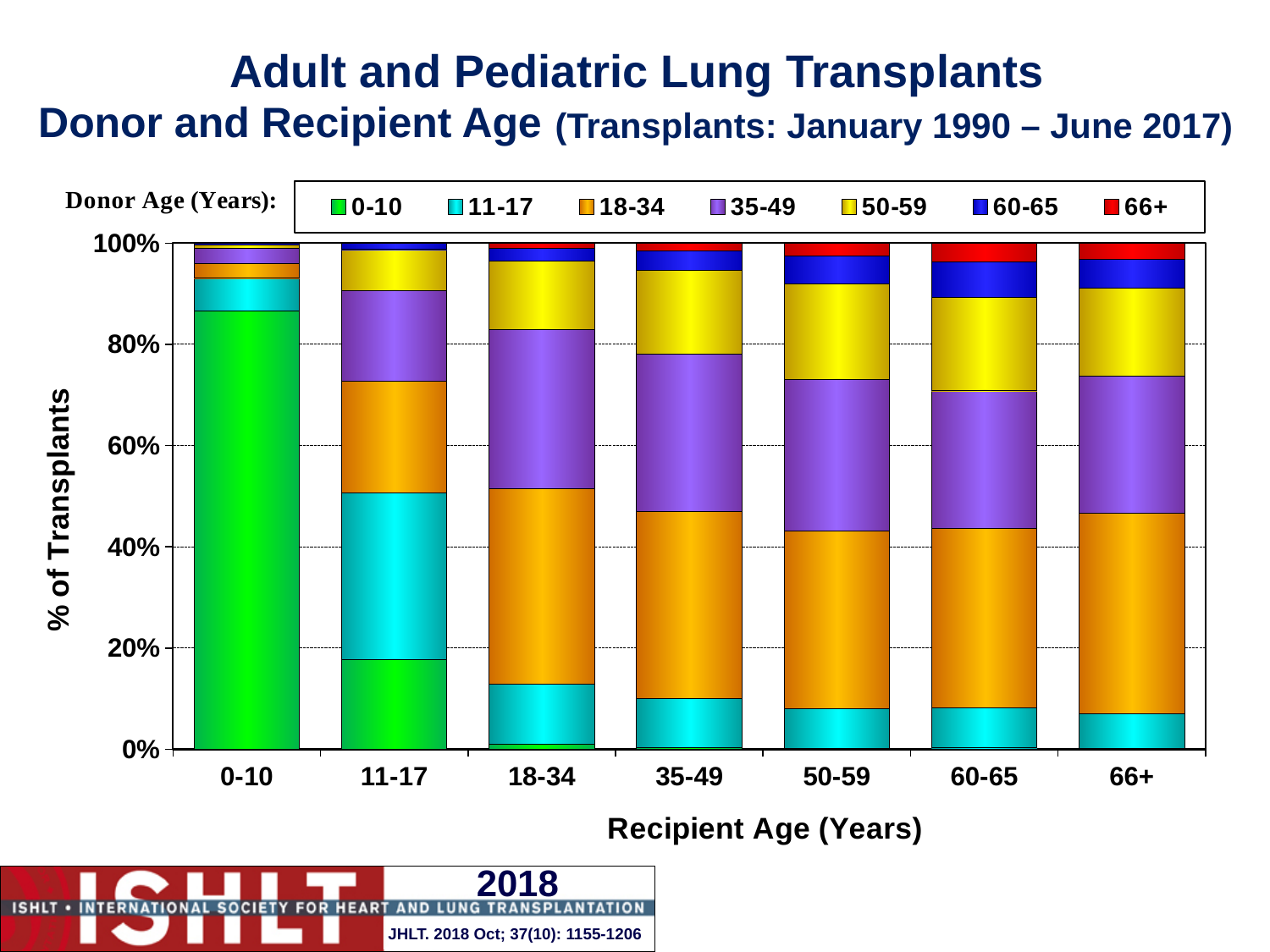
Which recipient age group has the largest share of donors aged 0-10? 0-10 How many recipient age groups are shown on the x axis? 7 What kind of chart is shown on the slide? Stacked bar chart For recipients aged 11-17, is the share of donors aged 0-10 greater or less than 20%? less How many donor age groups does the legend list? 7 For recipients aged 18-34, is the share of donors aged 18-34 greater or less than 20%? greater For recipients aged 66+, which donor age group has the larger share: 18-34 or 35-49? 18-34 From recipient age 11-17 to 66+, does the share of donors aged 11-17 rise or fall? fall What is the title of the legend on the chart? Donor Age (Years) Which recipient age group has the largest share of donors aged 11-17? 11-17 For recipients aged 0-10, is the share of donors aged 0-10 greater or less than 80%? greater For recipients aged 11-17, which donor age group has the larger share: 11-17 or 18-34? 11-17